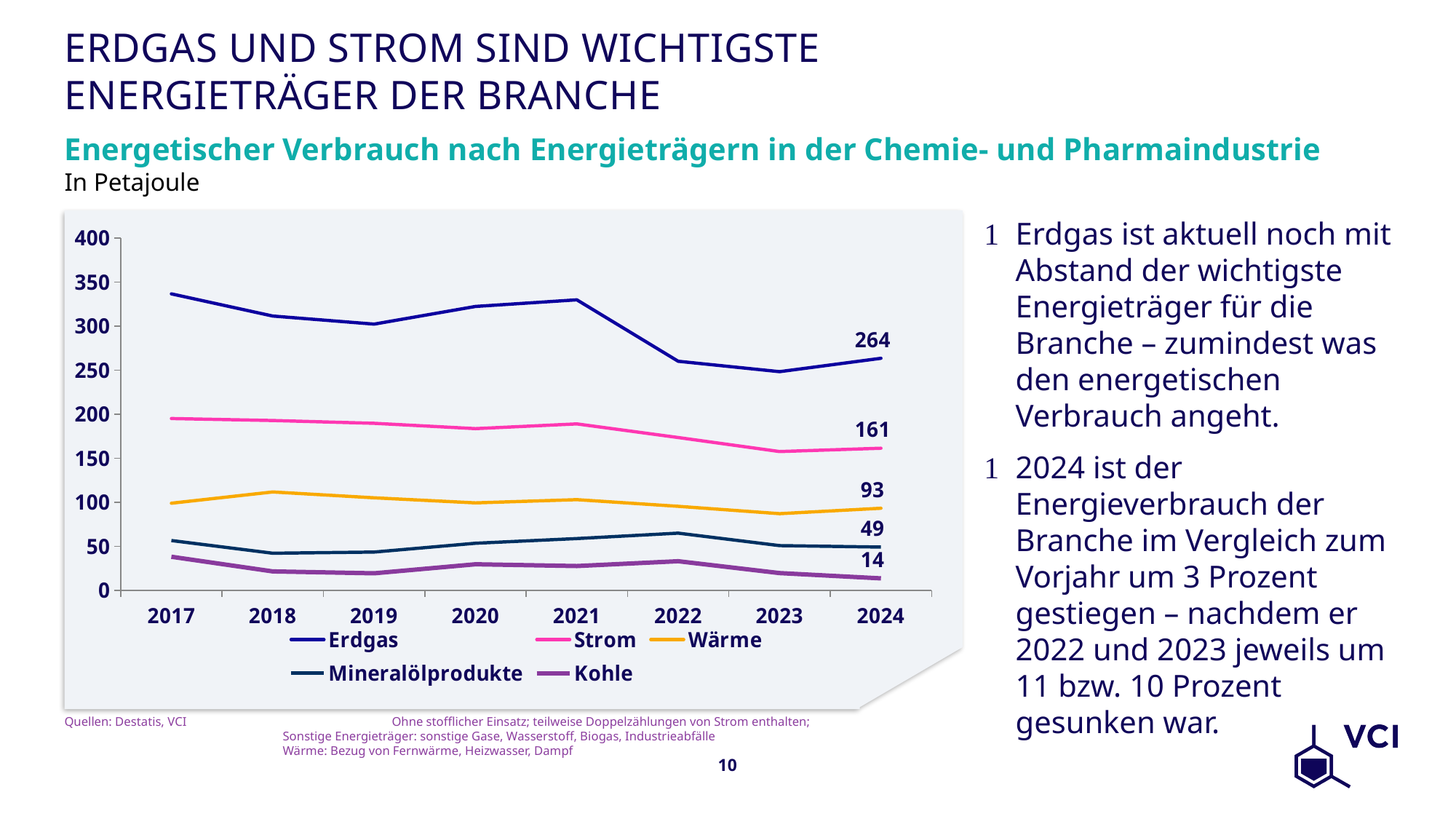
Which energy source has the lowest value in 2024? Kohle What kind of chart is shown on the slide? line chart Which energy source has the highest value in 2024? Erdgas What is the value for Wärme in 2024? 93 What is the value for Erdgas in 2024? 264 Does the Erdgas line rise or fall from 2021 to 2023? fall What is the value for Kohle in 2024? 14 Is the value for Erdgas in 2017 greater or less than 300? greater How many series does the legend list? 5 What is the difference between Erdgas and Strom in 2024? 103 What is the value for Strom in 2024? 161 How many years are shown on the x axis? 8